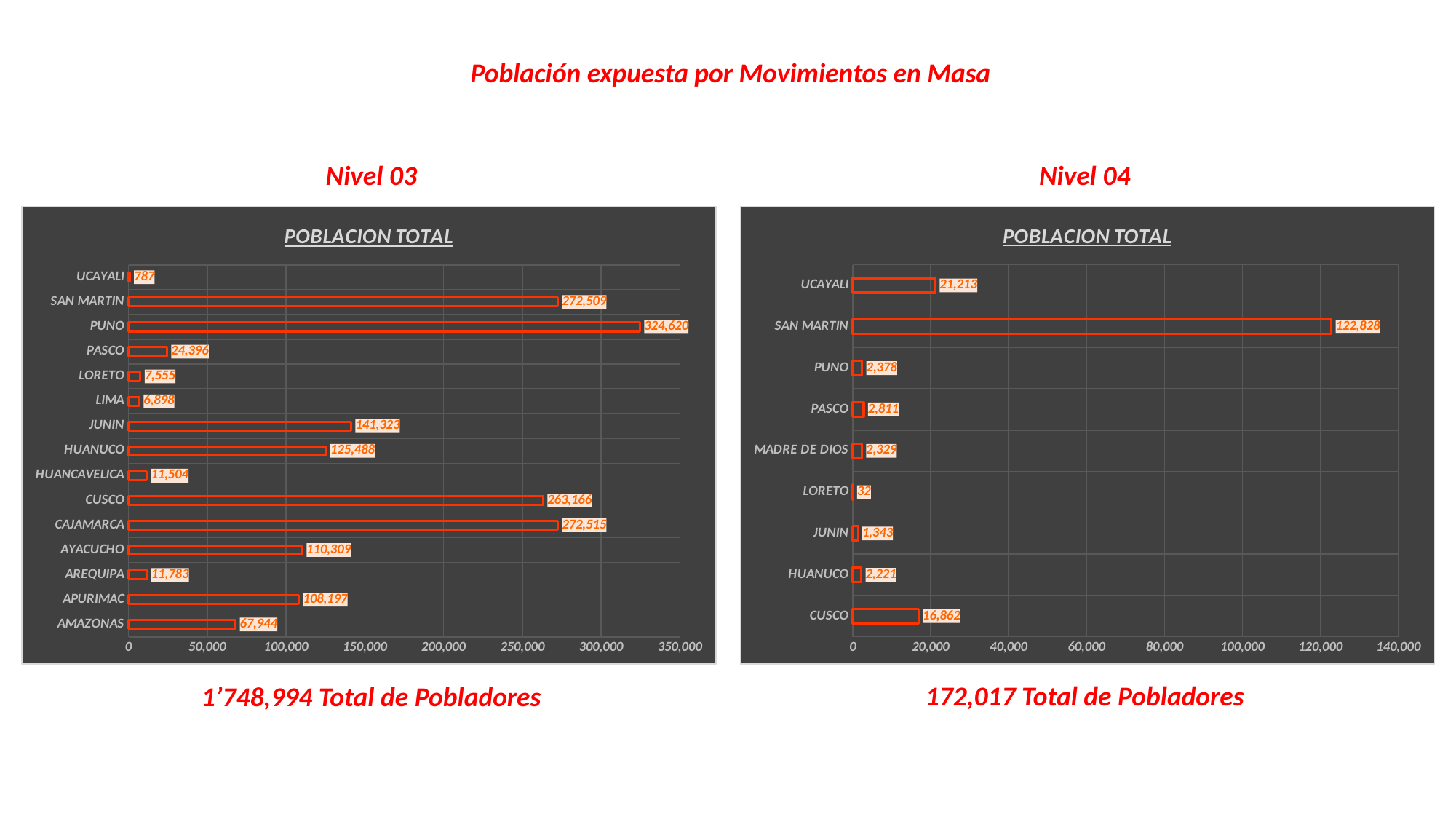
In the Nivel 04 chart, what is the difference between the values for UCAYALI and CUSCO? 4,351 In the Nivel 03 chart, what is the difference between the values for PUNO and SAN MARTIN? 52,111 In the Nivel 03 chart, which category has the lowest value? UCAYALI How many categories are shown in the Nivel 03 chart? 15 What kind of chart is the Nivel 04 chart? bar chart In the Nivel 04 chart, which category has the lowest value? LORETO In the Nivel 04 chart, what is the value for MADRE DE DIOS? 2,329 In the Nivel 03 chart, is the value for AMAZONAS greater or less than 50,000? greater In the Nivel 03 chart, what is the value for CAJAMARCA? 272,515 In the Nivel 03 chart, which is larger, the value for JUNIN or the value for HUANUCO? JUNIN How many categories are shown in the Nivel 04 chart? 9 In the Nivel 03 chart, which category has the highest value? PUNO